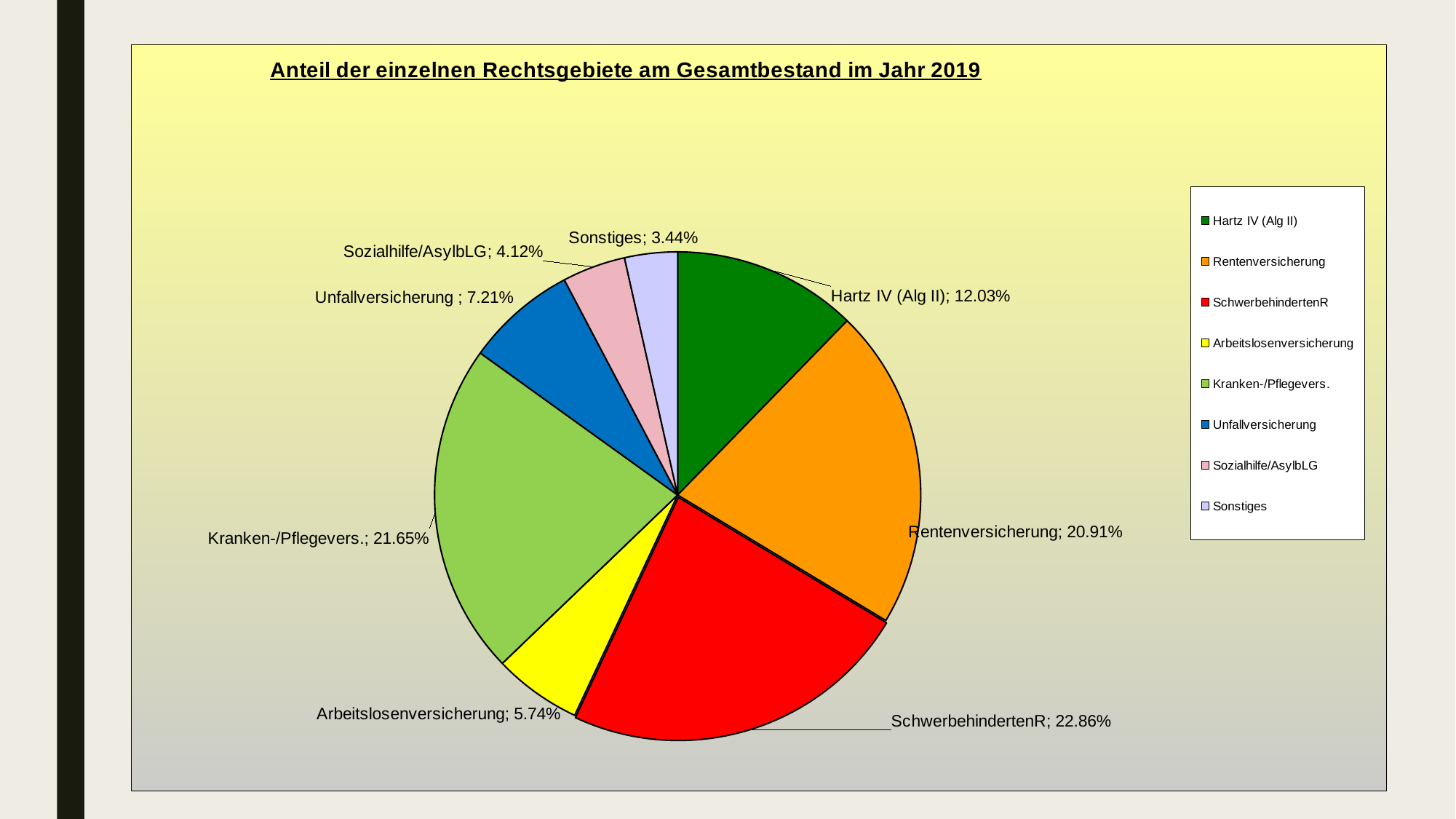
How many slices does the pie chart have? 8 Which category has the smallest slice of the pie? Sonstiges What colour is the slice for Sozialhilfe/AsylbLG? Pink What share of the pie does SchwerbehindertenR have? 22.86% What kind of chart is shown on the slide? Pie chart What is the difference between the shares of Kranken-/Pflegevers. and Rentenversicherung? 0.74% What is the value for Sonstiges? 3.44% What is the title of the chart? Anteil der einzelnen Rechtsgebiete am Gesamtbestand im Jahr 2019 Which is larger, the share for Unfallversicherung or the share for Arbeitslosenversicherung? Unfallversicherung Which category has the largest slice of the pie? SchwerbehindertenR What percentage is labelled for Hartz IV (Alg II)? 12.03% What is the value shown for Rentenversicherung? 20.91%